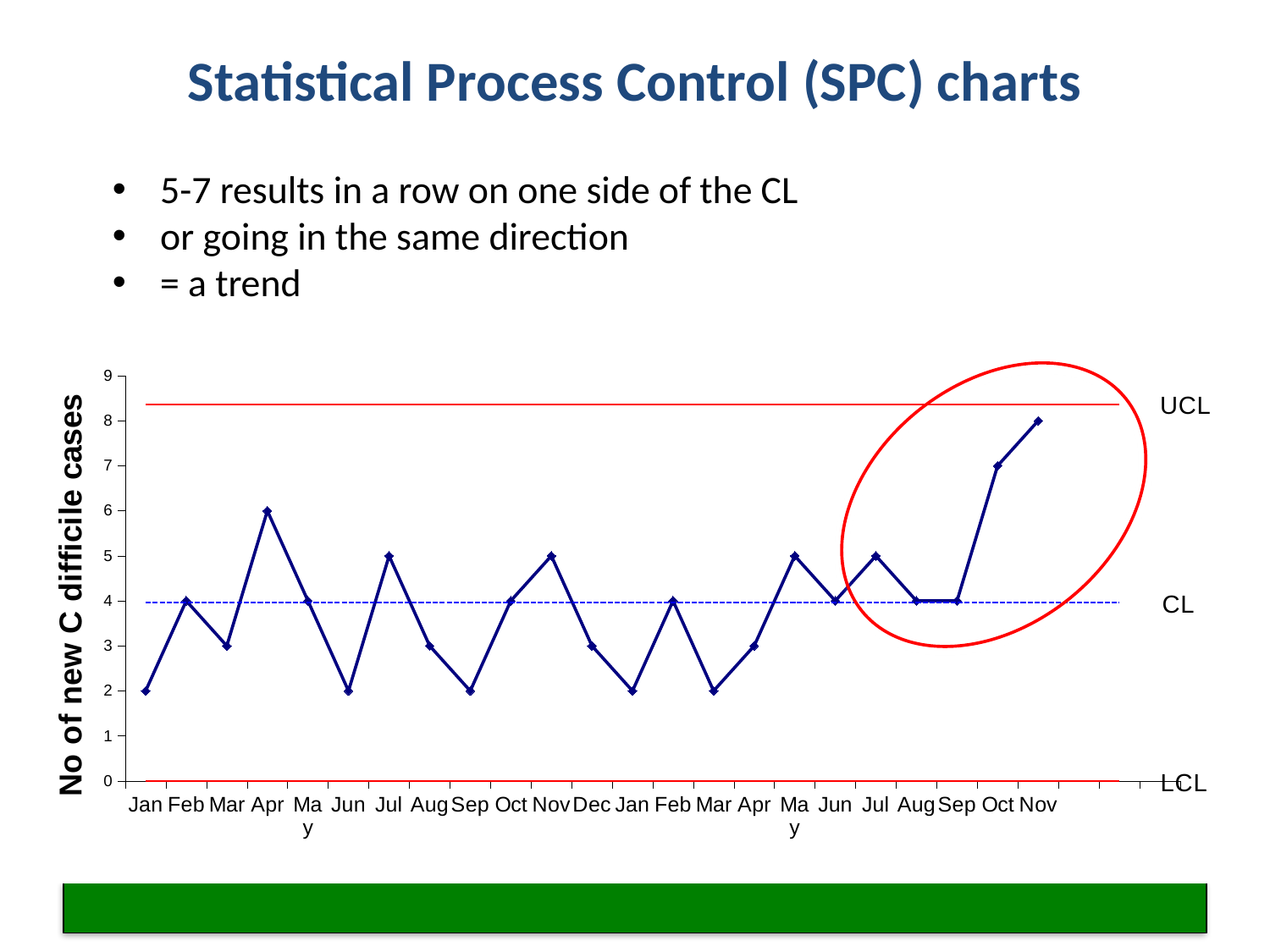
What is the lowest value plotted on the chart? 2 Do the values rise or fall over the last three points (Sep, Oct, Nov)? rise What is the value for the first Apr on the chart? 6 Which is larger, the value for the first Apr or the value for the first Jul? the first Apr What is the value for the first Jan on the chart? 2 What is the value for the last Nov (the final point) on the chart? 8 What is the difference between the value for the last Nov and the value for the second Oct? 1 How many data points are plotted on the line? 23 What kind of chart is shown on the slide? line chart What is the y-axis label of the chart? No of new C difficile cases Which month has the highest value on the chart? the last Nov What is the value for the second Oct on the chart? 7